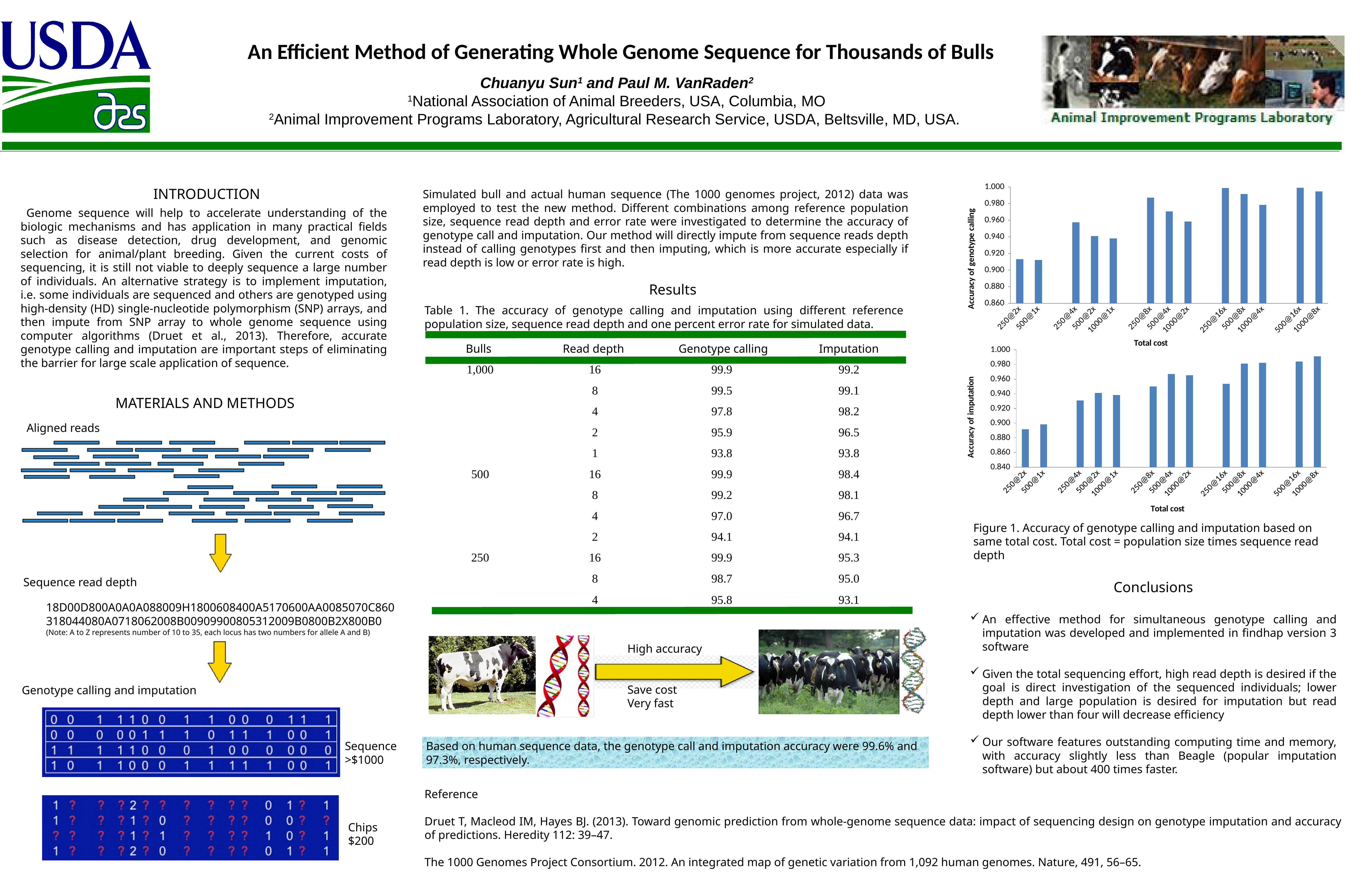
What kind of chart is the top chart on the right (Accuracy of genotype calling)? bar chart In the top chart (Accuracy of genotype calling), which is larger, the value for 250@8x or the value for 1000@2x? 250@8x What is the x-axis title of the bottom chart (Accuracy of imputation)? Total cost How many total-cost categories are shown on the x axis of the bottom chart (Accuracy of imputation)? 13 In the bottom chart (Accuracy of imputation), do the values generally rise or fall from left to right along the x axis? rise In the bottom chart (Accuracy of imputation), is the value for 250@2x greater or less than 0.900? less In the bottom chart (Accuracy of imputation), is the value for 250@8x greater or less than 0.960? less In the bottom chart (Accuracy of imputation), is the value for 1000@8x greater or less than 0.980? greater In the bottom chart (Accuracy of imputation), which is larger, the value for 500@8x or the value for 250@16x? 500@8x